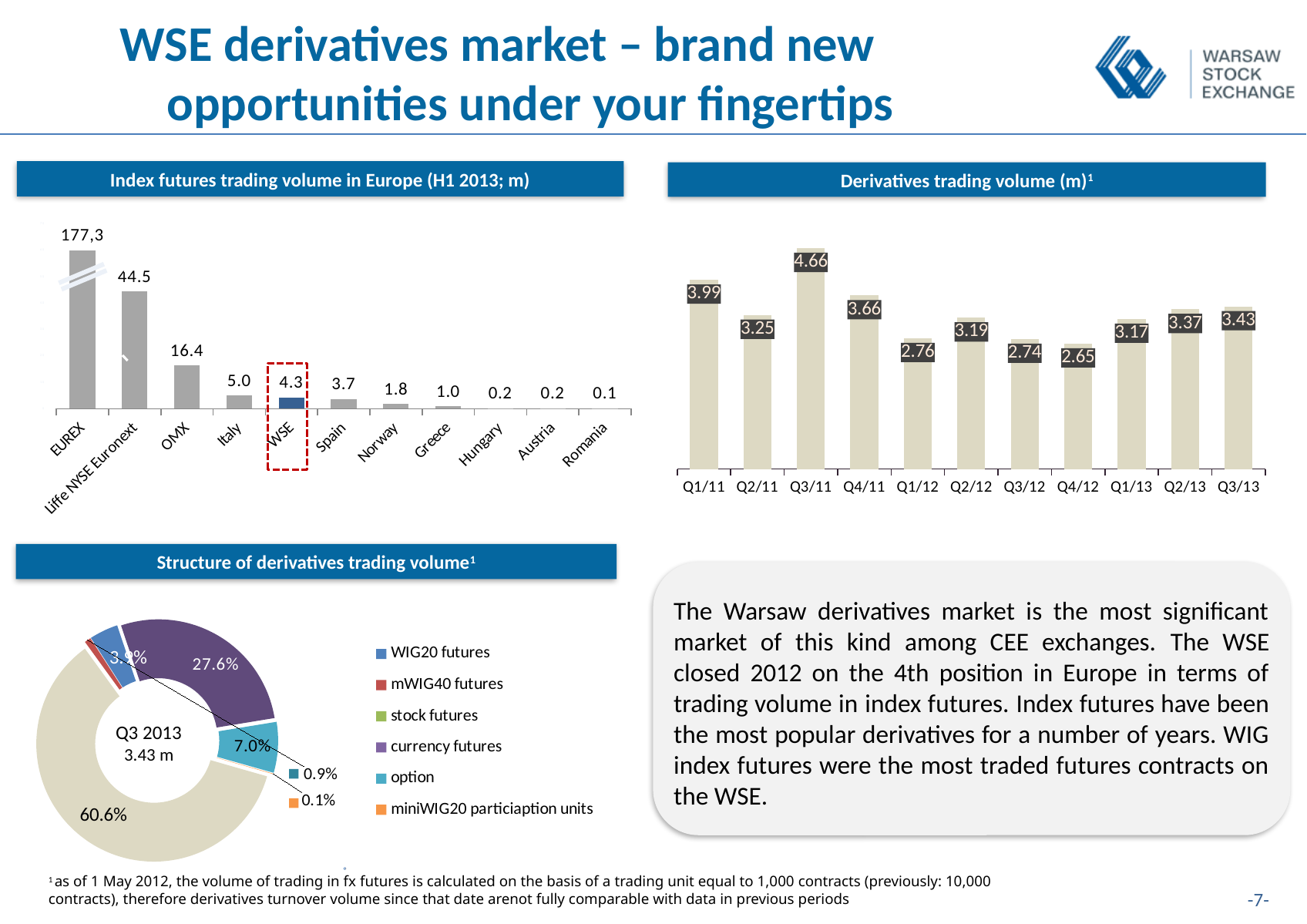
How many series does the legend of the 'Structure of derivatives trading volume' chart list? 6 In the 'Structure of derivatives trading volume' chart, what share does the largest slice have? 60.6% In the 'Derivatives trading volume (m)' chart, which is larger, the value for Q1/11 or Q1/13? Q1/11 In the 'Index futures trading volume in Europe (H1 2013; m)' chart, which exchange has the highest trading volume? EUREX In the 'Index futures trading volume in Europe (H1 2013; m)' chart, what is the value for WSE? 4.3 In the 'Index futures trading volume in Europe (H1 2013; m)' chart, how many exchanges/countries are shown? 11 In the 'Derivatives trading volume (m)' chart, which quarter has the lowest trading volume? Q4/12 What kind of chart is the 'Structure of derivatives trading volume' chart? Doughnut (pie) chart In the 'Derivatives trading volume (m)' chart, what is the difference between the values for Q3/13 and Q2/13? 0.06 In the 'Derivatives trading volume (m)' chart, what is the value for Q3/11? 4.66 In the 'Index futures trading volume in Europe (H1 2013; m)' chart, what is the value for OMX? 16.4 In the 'Index futures trading volume in Europe (H1 2013; m)' chart, what is the difference between the values for Italy and WSE? 0.7